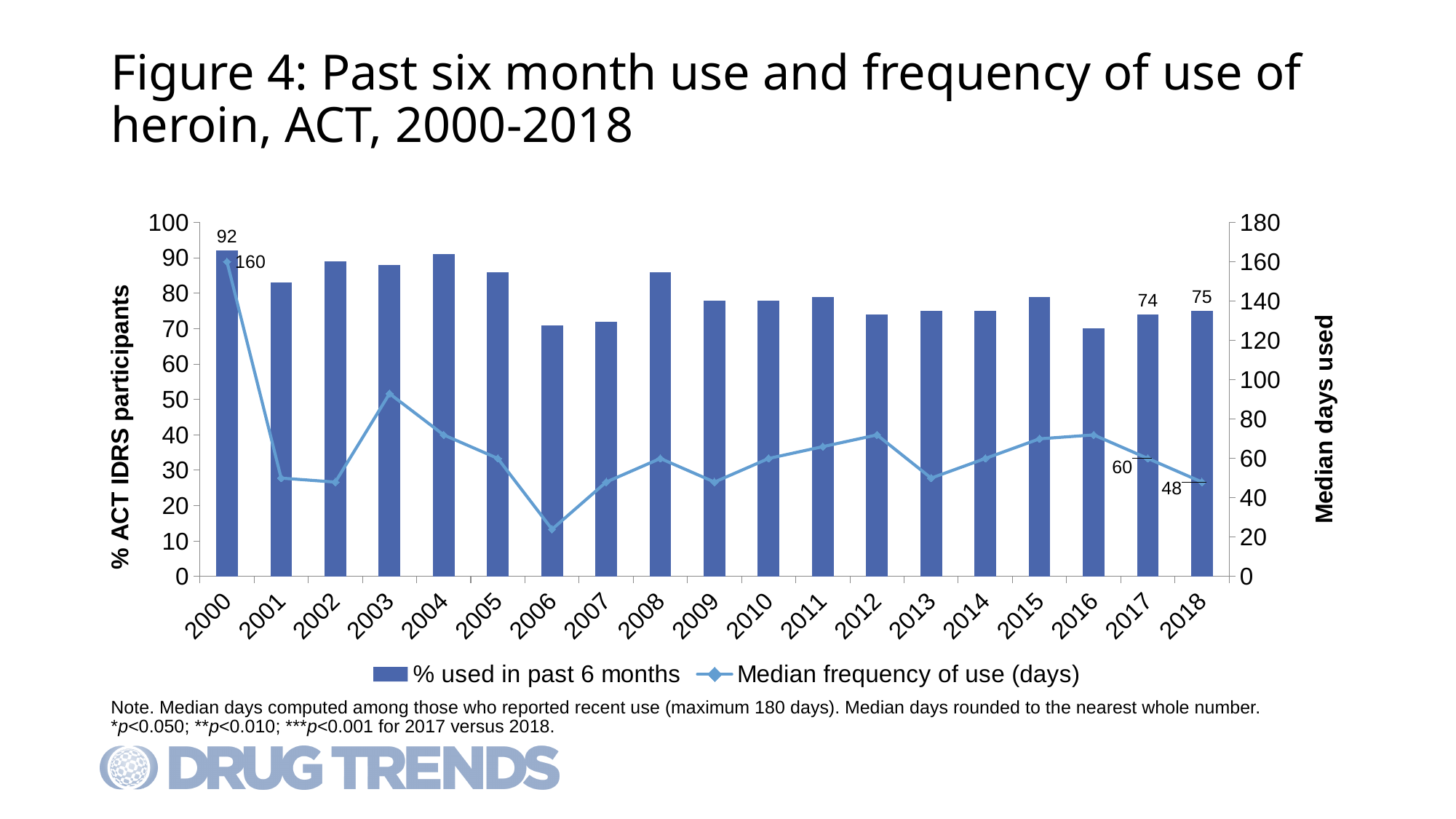
Is the median frequency of use for 2003 greater or less than 80 days? greater Which year has the lowest median frequency of use (days)? 2006 How many years are shown on the x axis of the chart? 19 What percentage of ACT IDRS participants reported using heroin in the past 6 months in 2000? 92 How many series does the legend list? 2 By how many days did the median frequency of use fall from 2017 to 2018? 12 What was the median frequency of heroin use (days) in 2017? 60 What was the median frequency of heroin use (days) in 2018? 48 What is the value of the '% used in past 6 months' bar for 2018? 75 What is the difference between the median frequency of use in 2000 and in 2018? 112 Which year has the highest median frequency of use (days)? 2000 Is the '% used in past 6 months' value for 2006 greater or less than 80? less